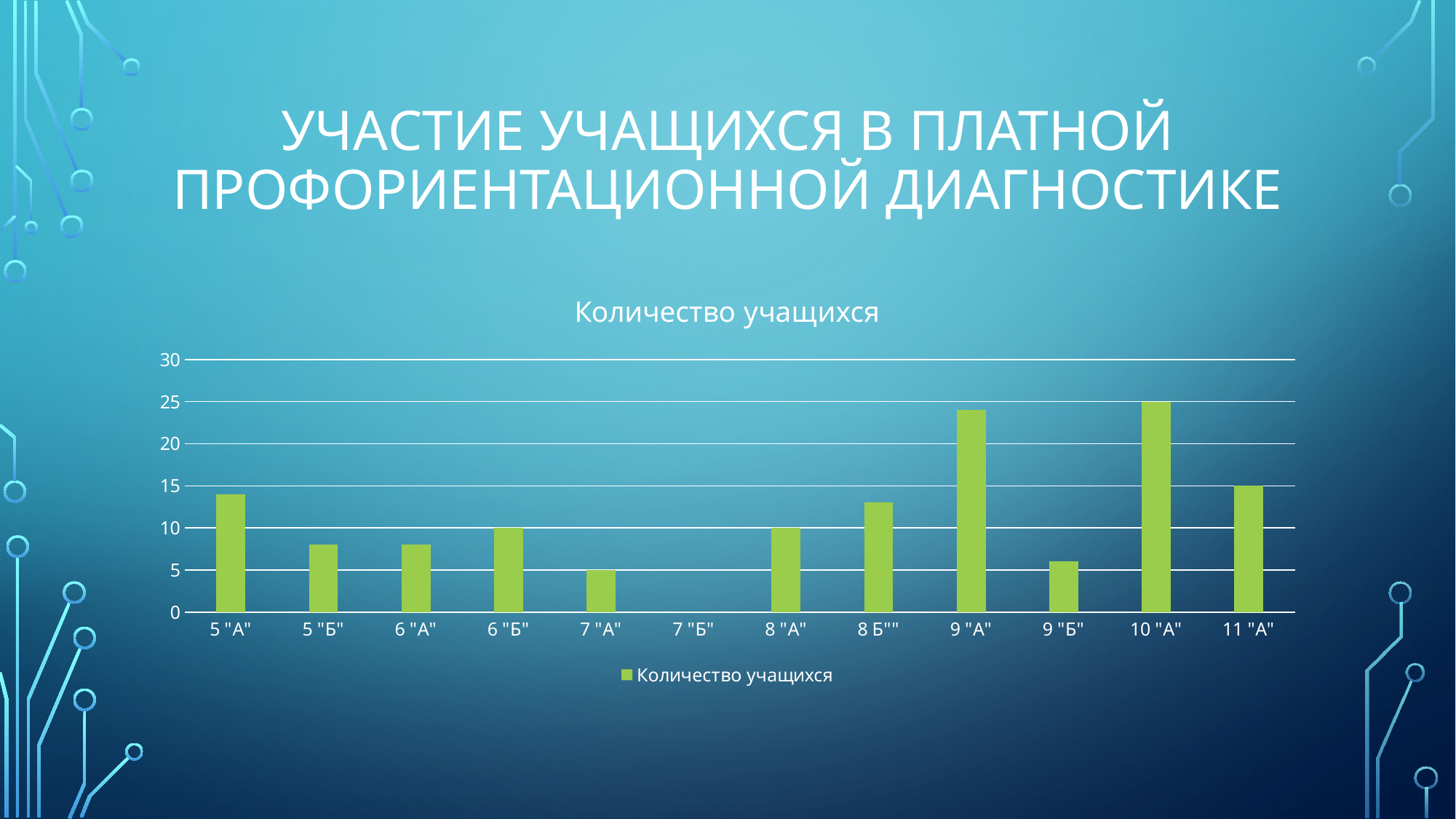
What kind of chart is this? bar chart What is the value for 11 "А"? 15 Is the value for 9 "Б" greater or less than 10? less How many categories are shown on the x axis? 12 How many series does the legend list? 1 What is the value for 6 "Б"? 10 Which is larger, the value for 5 "А" or 5 "Б"? 5 "А" Is the value for 9 "А" greater or less than 20? greater Which category has the highest value? 10 "А" What is the difference between the values for 10 "А" and 11 "А"? 10 What is the value for 7 "А"? 5 What is the value for 10 "А"? 25